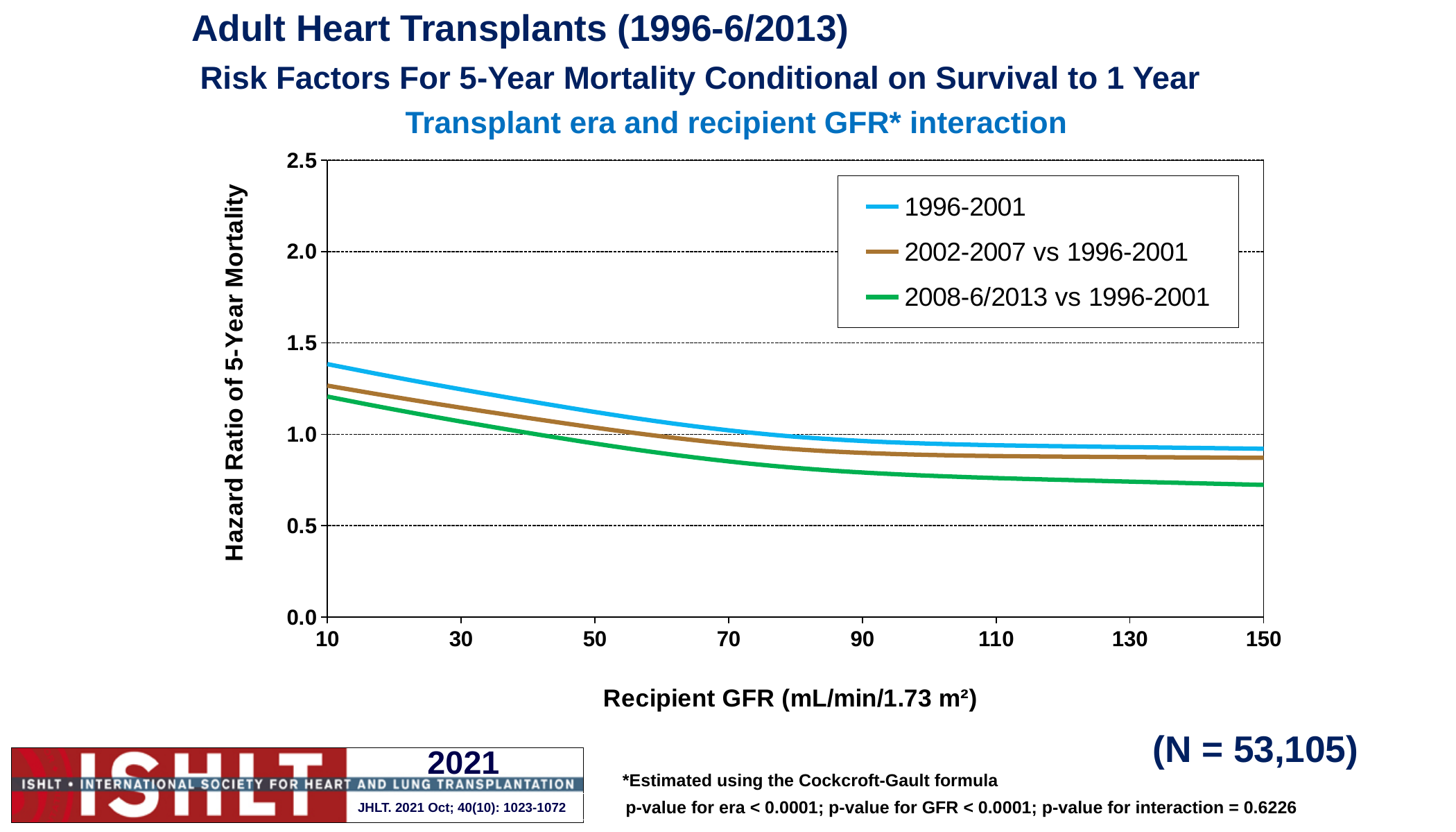
Is the hazard ratio for the 1996-2001 series at a recipient GFR of 10 greater or less than 1.0? greater Which series is drawn in green? 2008-6/2013 vs 1996-2001 At a recipient GFR of 150, which series has the lowest hazard ratio? 2008-6/2013 vs 1996-2001 Is the hazard ratio for the 2008-6/2013 vs 1996-2001 series at a recipient GFR of 150 greater or less than 1.0? less Is the hazard ratio for the 2002-2007 vs 1996-2001 series at a recipient GFR of 150 greater or less than 1.0? less How many series does the legend list? 3 At a recipient GFR of 10, which series has the higher hazard ratio: 1996-2001 or 2008-6/2013 vs 1996-2001? 1996-2001 What is the label of the y axis? Hazard Ratio of 5-Year Mortality Does the hazard ratio rise or fall as recipient GFR increases from 10 to 150? fall Which series has the highest hazard ratio across the whole GFR range? 1996-2001 What kind of chart is shown on the slide? line chart